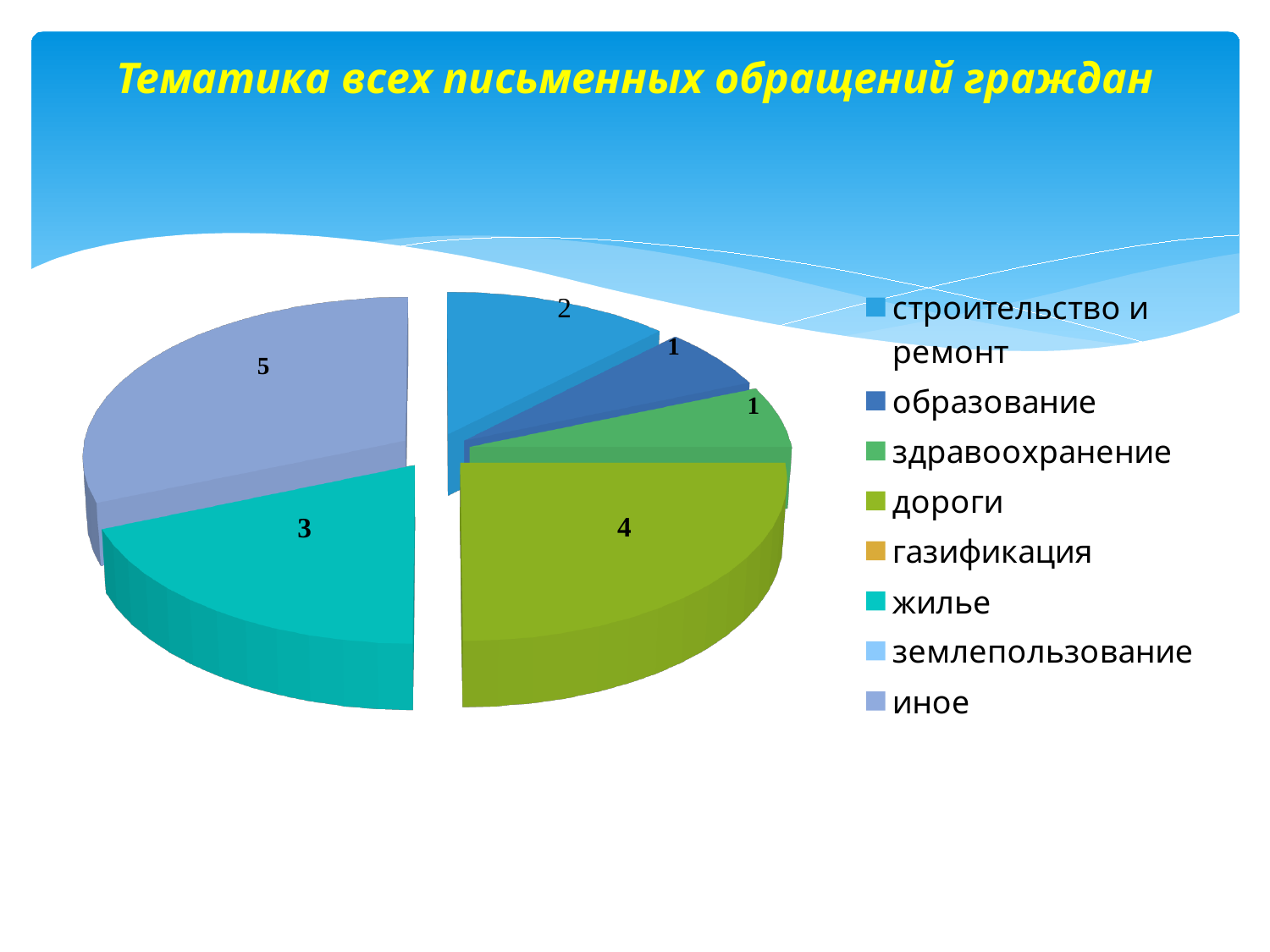
Which category is shown in teal in the legend? жилье What is the value shown for жилье? 3 What is the value shown for иное? 5 What is the title of the chart? Тематика всех письменных обращений граждан What kind of chart is shown on the slide? pie chart What is the value shown for дороги? 4 What is the difference between the values for иное and дороги? 1 What is the value shown for образование? 1 Which category has the largest slice? иное What is the value shown for строительство и ремонт? 2 How many entries does the legend list? 8 Which is larger, the value for дороги or the value for жилье? дороги